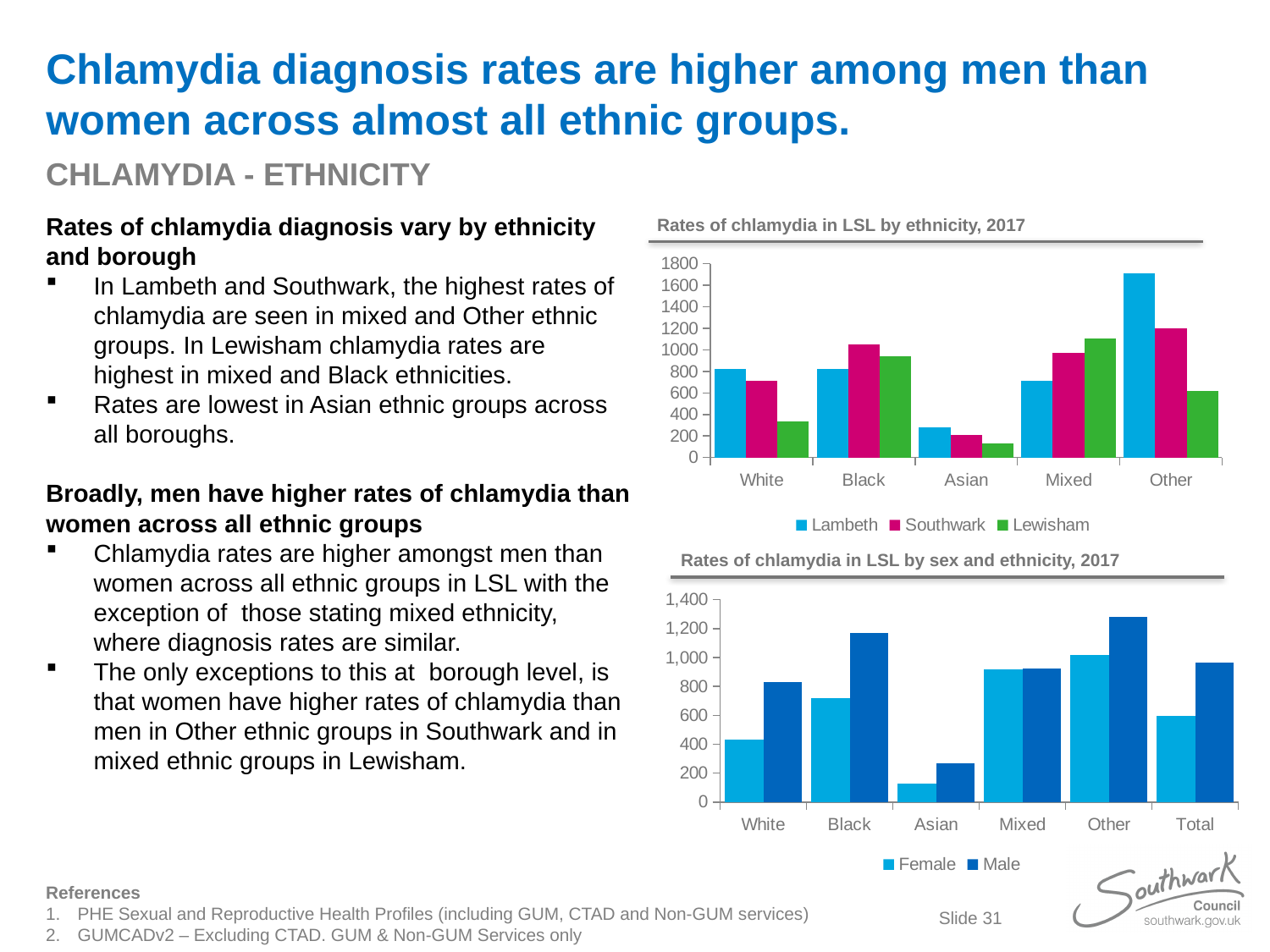
In the chart 'Rates of chlamydia in LSL by sex and ethnicity, 2017', is the Male value for Other greater or less than 1,200? greater In the chart 'Rates of chlamydia in LSL by ethnicity, 2017', which is larger for Black: Southwark or Lewisham? Southwark In the chart 'Rates of chlamydia in LSL by ethnicity, 2017', which ethnic group has the highest rate for Lambeth? Other In the chart 'Rates of chlamydia in LSL by ethnicity, 2017', which ethnic group has the lowest rate for Lewisham? Asian In the chart 'Rates of chlamydia in LSL by sex and ethnicity, 2017', which category has the highest Female rate? Other In the chart 'Rates of chlamydia in LSL by sex and ethnicity, 2017', is the Female value for Asian greater or less than 200? less In the chart 'Rates of chlamydia in LSL by ethnicity, 2017', is the Lewisham value for White greater or less than 400? less In the chart 'Rates of chlamydia in LSL by sex and ethnicity, 2017', which is larger for White: Female or Male? Male How many series does the legend of the chart 'Rates of chlamydia in LSL by ethnicity, 2017' list? 3 What kind of chart is 'Rates of chlamydia in LSL by sex and ethnicity, 2017'? bar chart How many ethnic groups are shown on the x axis of the chart 'Rates of chlamydia in LSL by ethnicity, 2017'? 5